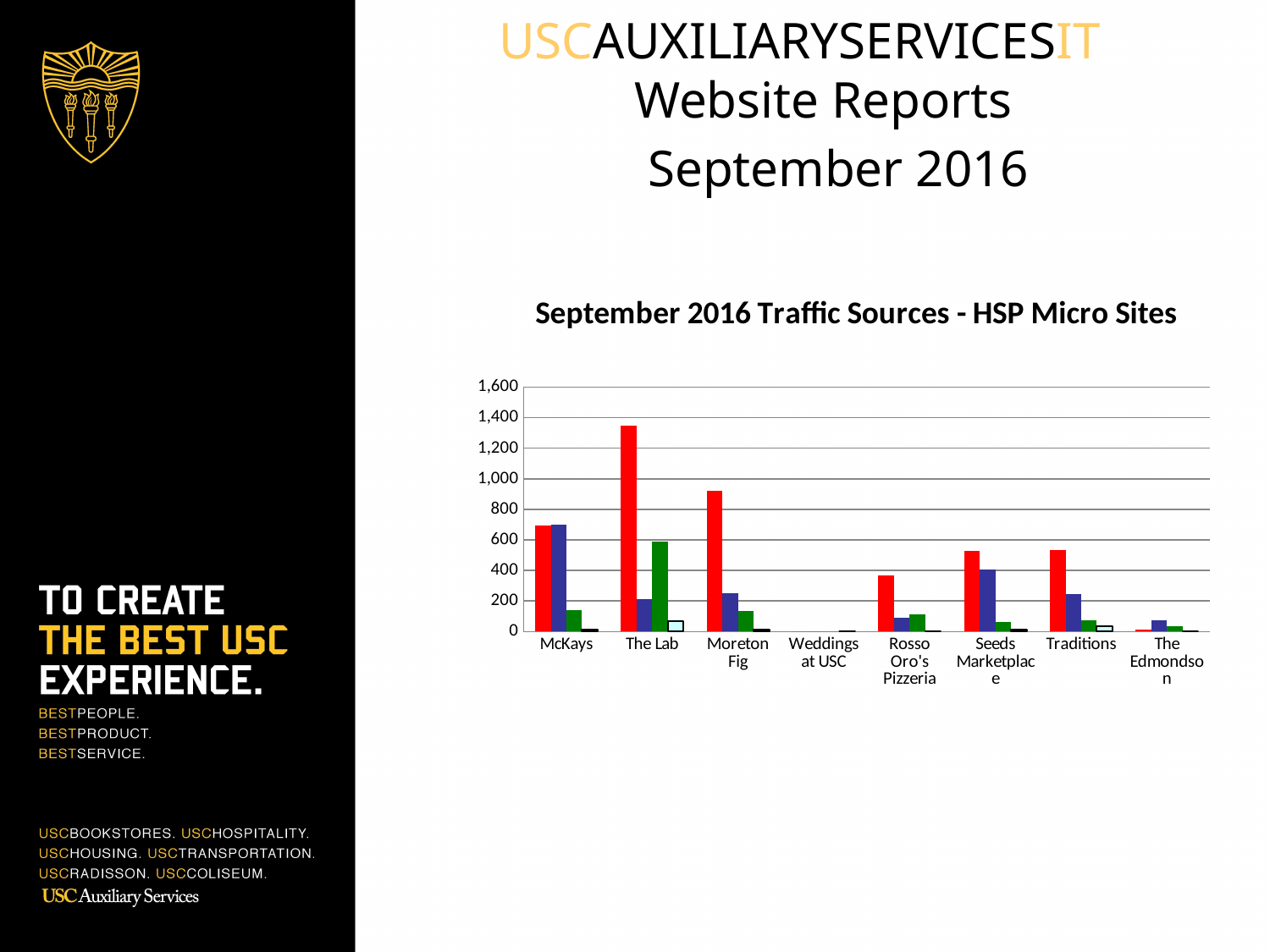
Which is larger, the blue bar for McKays or the blue bar for Seeds Marketplace? McKays Which micro site has the tallest red bar in the chart? The Lab Is the red bar for Rosso Oro's Pizzeria greater or less than 400? less Which micro site has the lowest red bar in the chart? Weddings at USC How many micro sites (categories) are shown on the x axis of the chart? 8 Which micro site has the tallest green bar in the chart? The Lab What is the title of the chart? September 2016 Traffic Sources - HSP Micro Sites Which is larger, the red bar for The Lab or the red bar for Moreton Fig? The Lab What kind of chart is shown on the slide? bar chart Is the red bar for Moreton Fig greater or less than 800? greater Is the red bar for The Lab greater or less than 1,200? greater